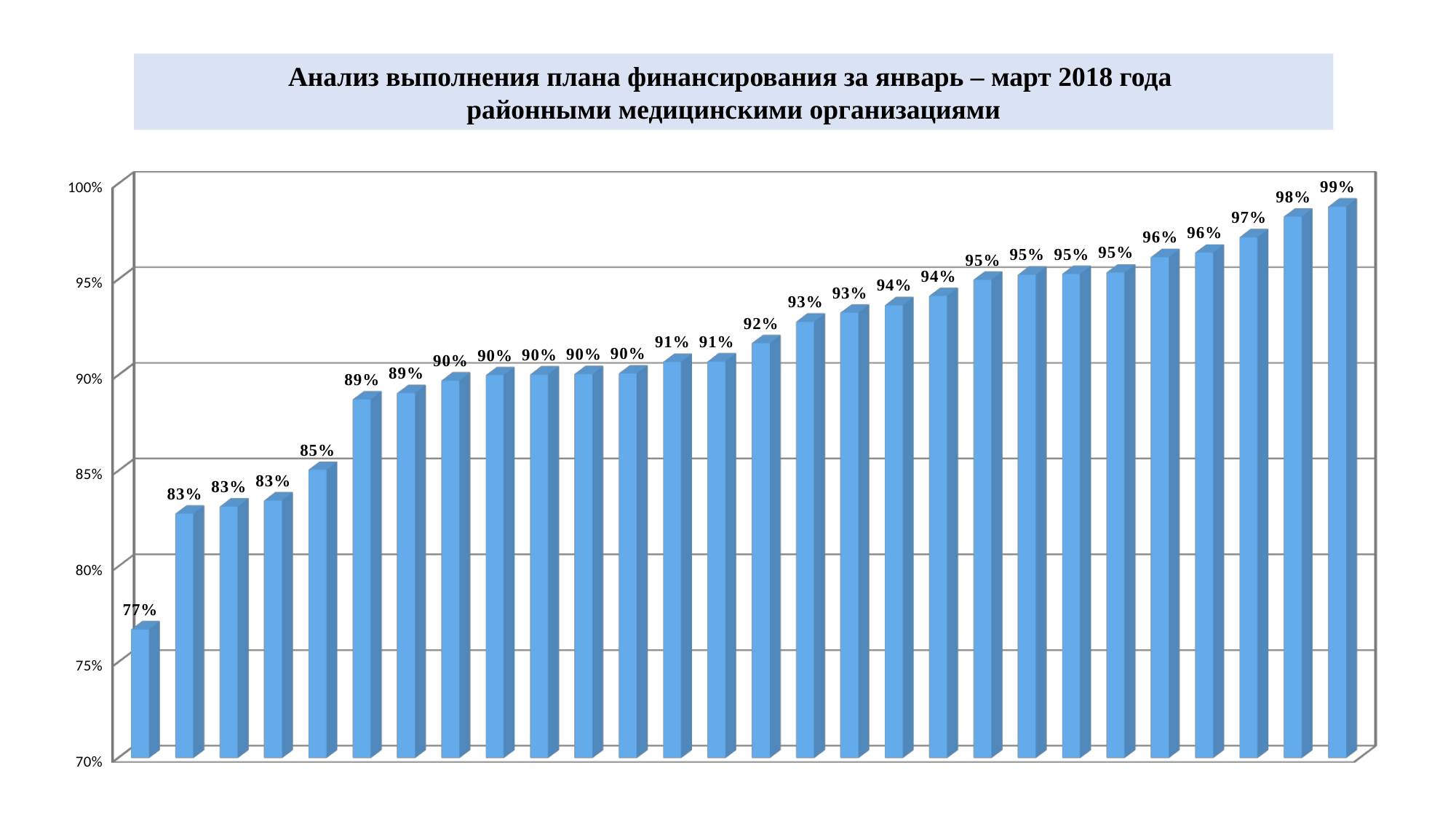
What is the lowest value shown in the chart? 77% What is the difference between the highest and lowest values in the chart? 22 percentage points What kind of chart is shown on the slide? Bar chart What is the lowest value shown on the vertical axis? 70% What is the value of the first (leftmost) bar? 77% How many bars have a data label of 95%? 4 Do the values rise or fall from left to right along the x axis? Rise Is the value of the leftmost bar greater or less than 80%? less What is the highest value shown in the chart? 99% How many bars have a data label of 90%? 5 How many bars are plotted in the chart? 28 What is the value of the last (rightmost) bar? 99%